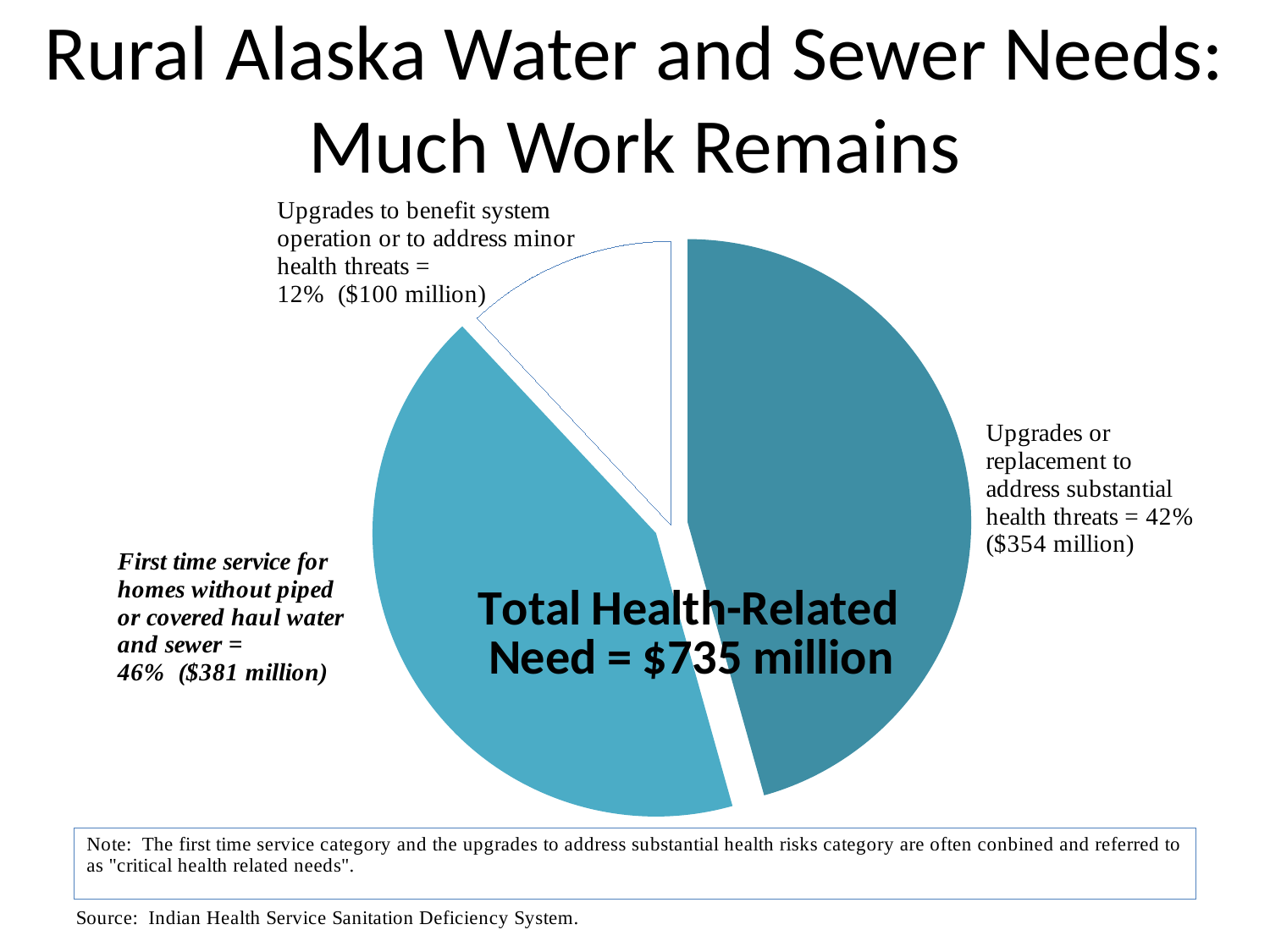
What is the difference in dollars between the first time service category and the substantial health threats category? $27 million What is the total health-related need shown in the centre of the pie chart? $735 million Which category has the largest slice of the pie? First time service for homes without piped or covered haul water and sewer What kind of chart is shown on the slide? pie chart How many slices does the pie chart have? 3 What share of the pie is 'Upgrades to benefit system operation or to address minor health threats'? 12% Which category has the smallest slice of the pie? Upgrades to benefit system operation or to address minor health threats What share of the pie is 'First time service for homes without piped or covered haul water and sewer'? 46% What dollar amount is shown for 'Upgrades to benefit system operation or to address minor health threats'? $100 million Which is larger: the share for substantial health threats or the share for minor health threats? substantial health threats What is the source cited for the chart? Indian Health Service Sanitation Deficiency System What dollar amount is shown for 'Upgrades or replacement to address substantial health threats'? $354 million